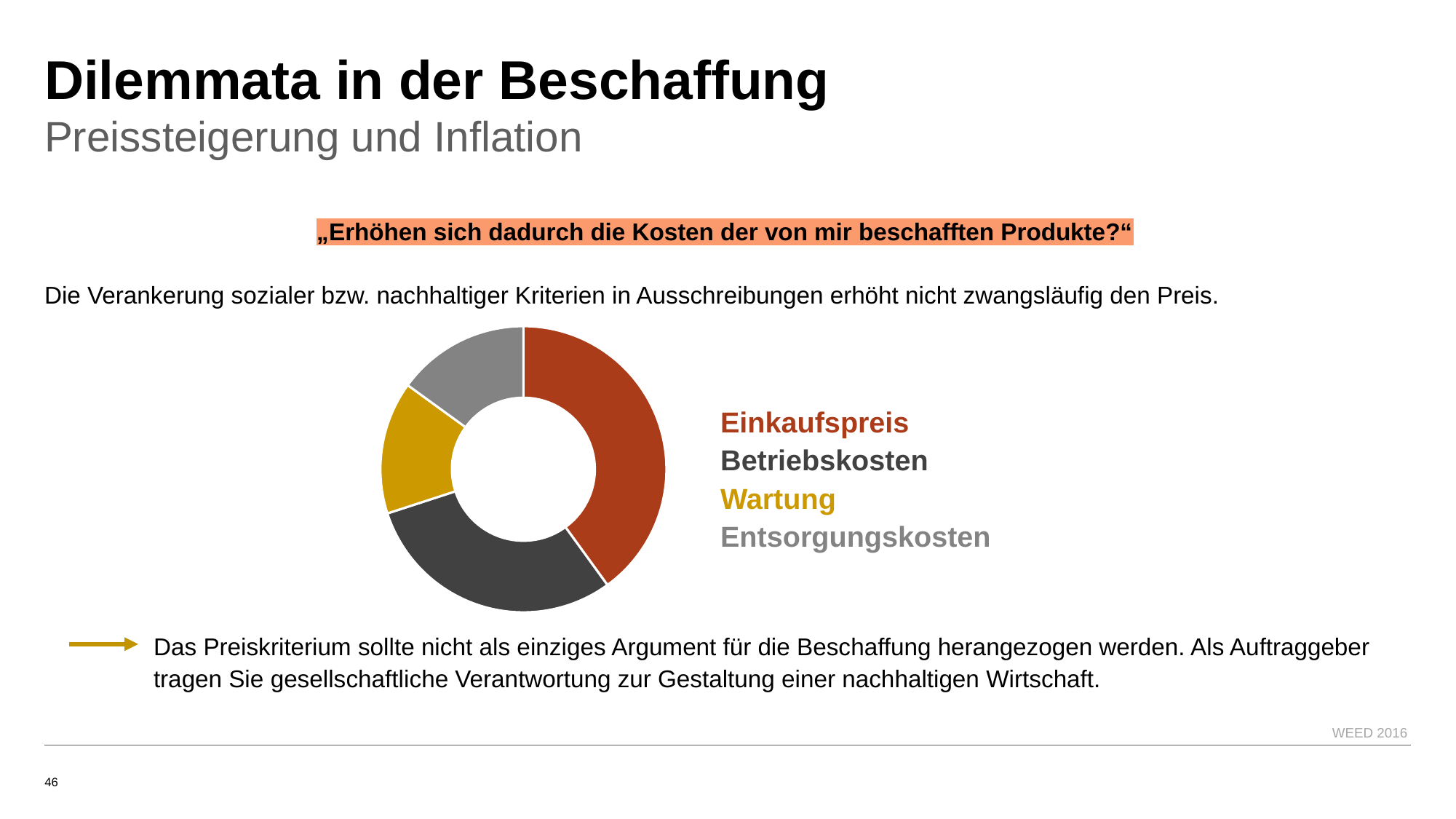
How many segments does the doughnut chart have? 4 What kind of chart is shown on the slide? Doughnut chart Which category takes up the largest share of the doughnut chart? Einkaufspreis Which category is shown in gold/yellow in the doughnut chart? Wartung Which segment is larger in the doughnut chart, Einkaufspreis or Entsorgungskosten? Einkaufspreis Which segment is larger in the doughnut chart, Einkaufspreis or Betriebskosten? Einkaufspreis Which category is shown in light grey in the doughnut chart? Entsorgungskosten How many entries does the legend next to the doughnut chart list? 4 Which segment is larger in the doughnut chart, Betriebskosten or Wartung? Betriebskosten